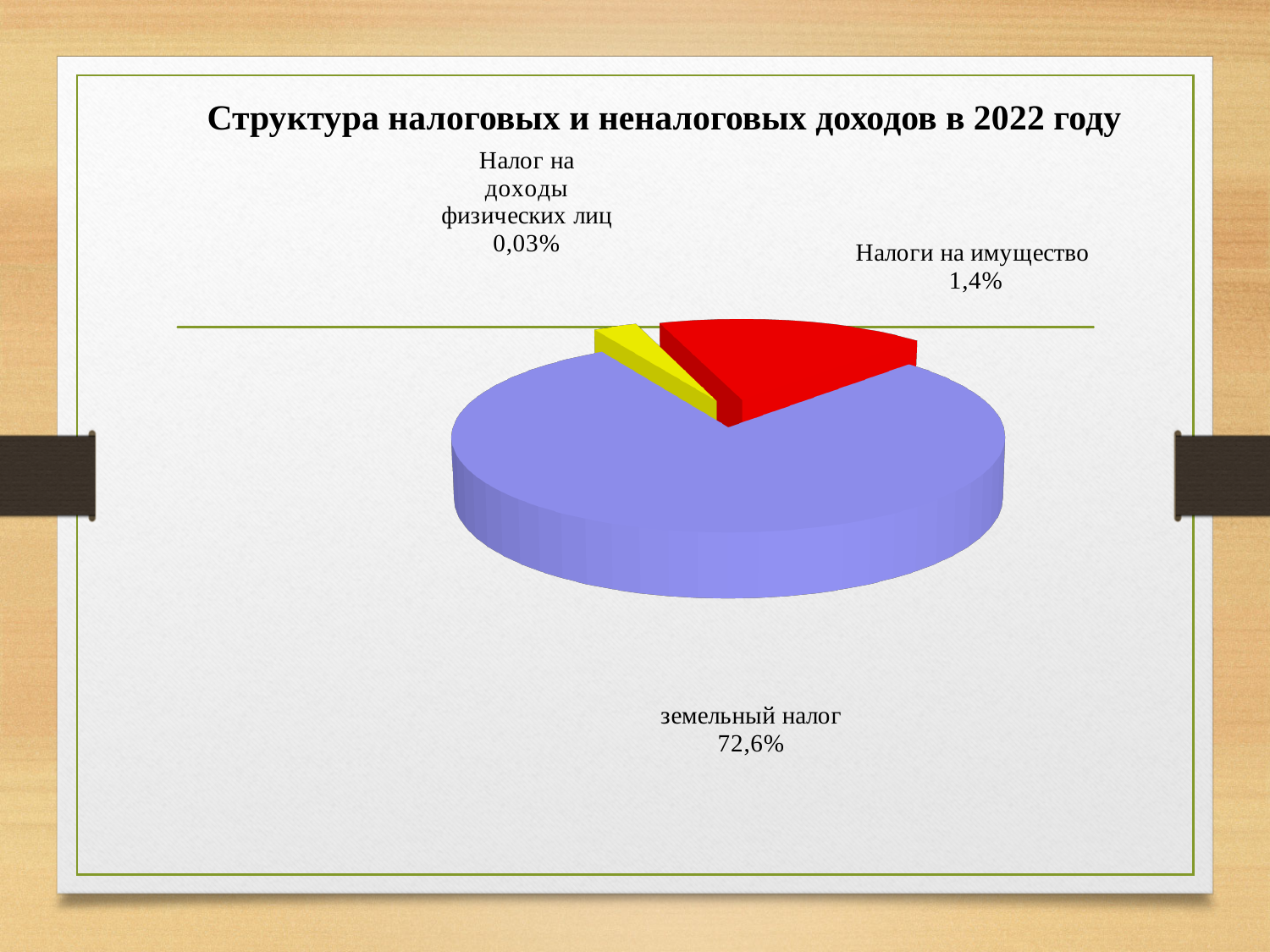
How many slices does the pie chart have? 3 What type of chart is shown on the slide? pie chart What value is shown for Налог на доходы физических лиц? 0,03% Which is larger, Налоги на имущество or Налог на доходы физических лиц? Налоги на имущество Which category has the smallest slice? Налог на доходы физических лиц What value is shown for Налоги на имущество? 1,4% What value is shown for земельный налог? 72,6% What is the title of the chart? Структура налоговых и неналоговых доходов в 2022 году What colour is the slice for земельный налог? blue (purple-blue) What is the difference between the values for земельный налог and Налоги на имущество? 71,2% Which category has the largest slice? земельный налог